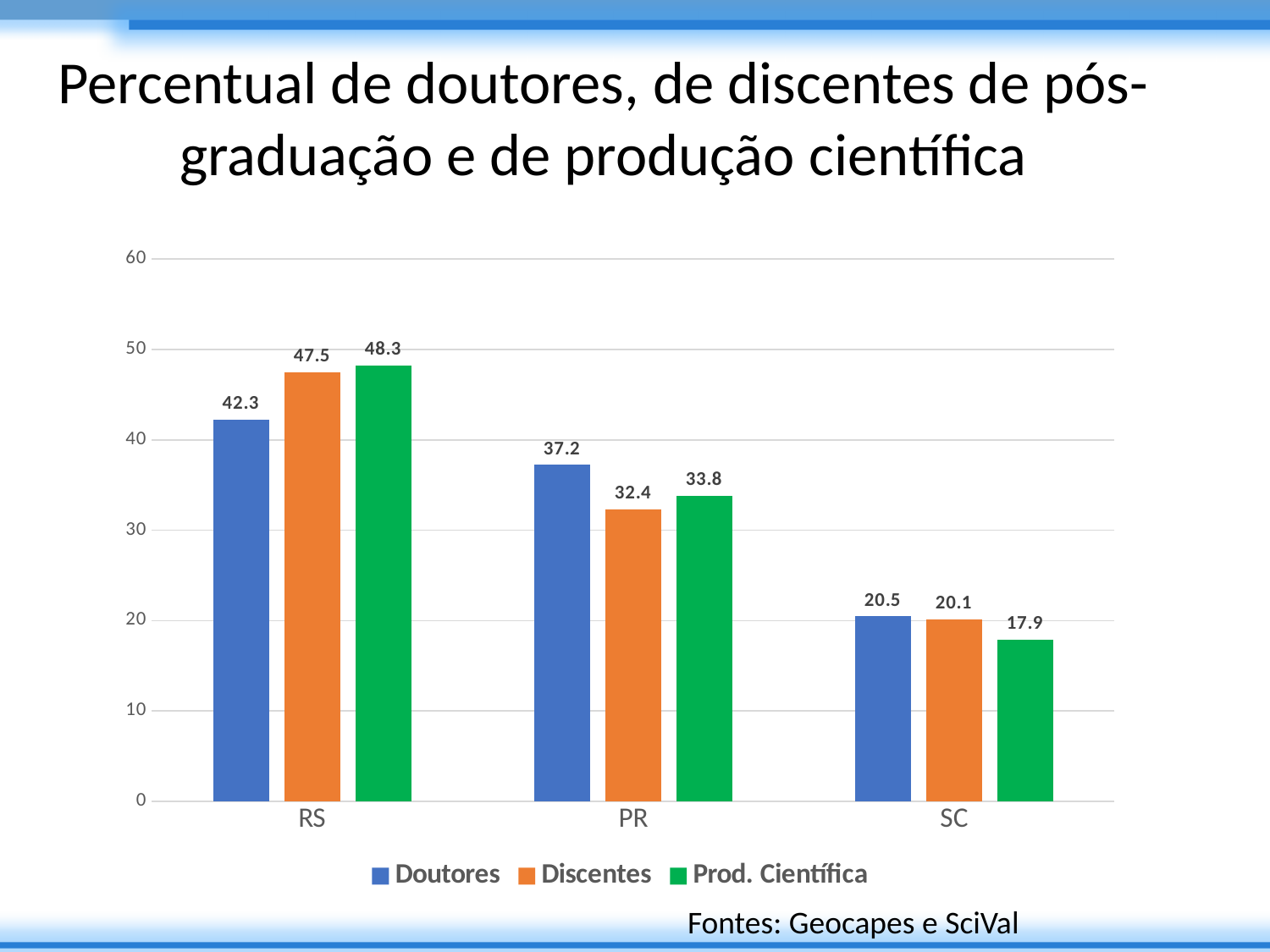
How many states are shown on the x axis? 3 How many series does the legend list? 3 What is the value for Prod. Científica in SC? 17.9 What kind of chart is shown on the slide? bar chart Which is larger in PR: Doutores or Discentes? Doutores What colour are the Discentes bars? orange What is the value for Doutores in RS? 42.3 Is the value for Discentes in RS greater or less than 40? greater What is the value for Discentes in PR? 32.4 Which state has the highest value for Prod. Científica? RS What is the difference between Prod. Científica and Doutores in RS? 6 Which state has the lowest value for Doutores? SC